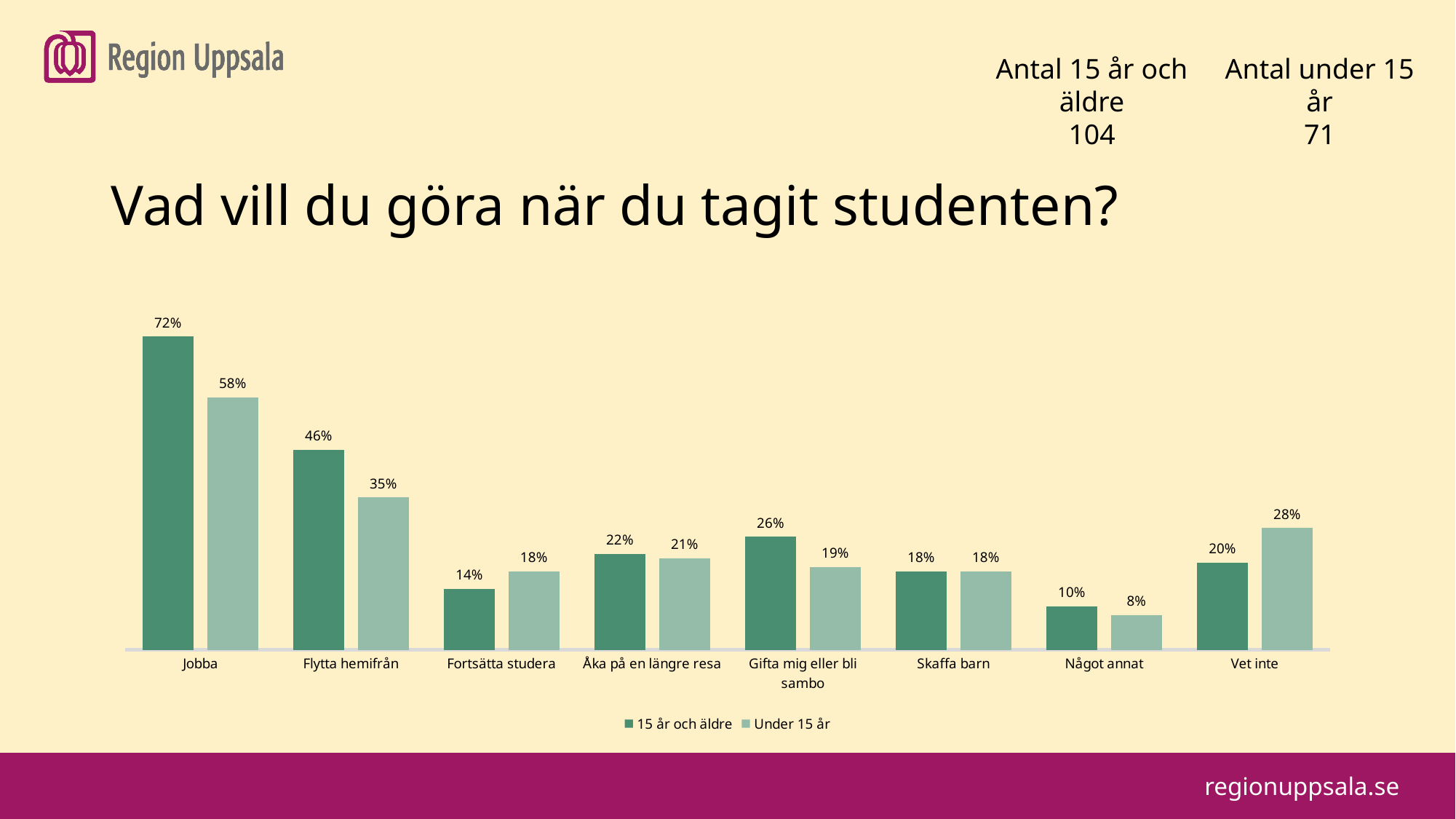
What kind of chart is shown on the slide? Bar chart How many series does the legend list? 2 What is the title of the chart? Vad vill du göra när du tagit studenten? What is the difference between the 15 år och äldre and Under 15 år values for Jobba? 14% Which series has the larger value for Vet inte? Under 15 år How many categories are shown on the x axis? 8 What is the difference between the 15 år och äldre and Under 15 år values for Flytta hemifrån? 11% What is the value for Vet inte in the Under 15 år series? 28% What is the value for Jobba in the 15 år och äldre series? 72% Which category has the lowest value in the 15 år och äldre series? Något annat Which category has the highest value in the Under 15 år series? Jobba What is the value for Fortsätta studera in the 15 år och äldre series? 14%